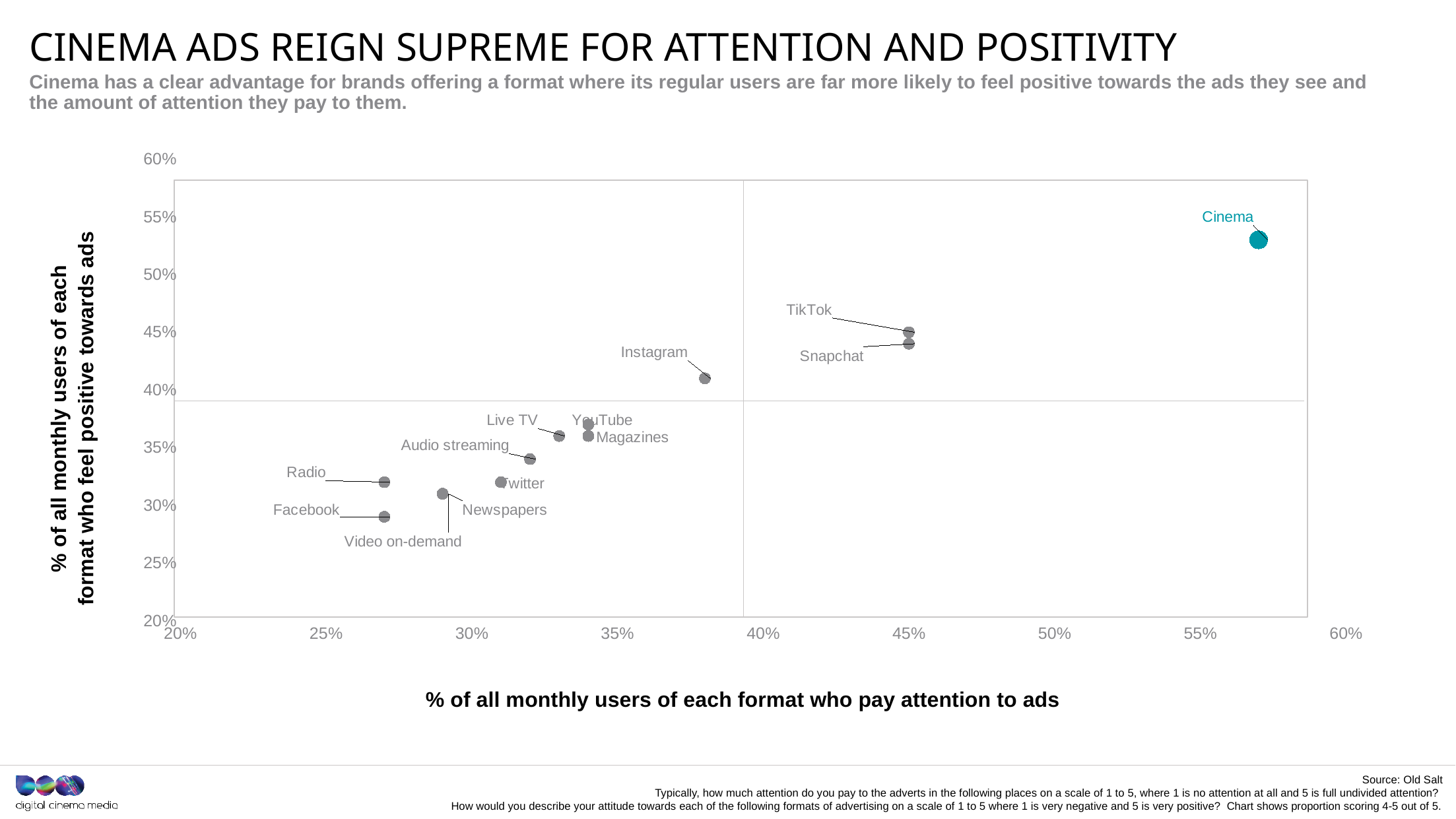
Is the percentage of Cinema users who pay attention to ads greater or less than 55%? greater Which format has the highest percentage of monthly users who pay attention to ads? Cinema Which format has a higher percentage of users who feel positive towards ads, Cinema or Snapchat? Cinema Which format has the lowest percentage of monthly users who feel positive towards ads? Facebook How many advertising formats are labelled on the chart? 13 Is the percentage of Cinema users who feel positive towards ads greater or less than 50%? greater What is the title of the horizontal axis of the chart? % of all monthly users of each format who pay attention to ads Is the percentage of Radio users who pay attention to ads greater or less than 30%? less Which format has the highest percentage of monthly users who feel positive towards ads? Cinema Which format has a higher percentage of users who pay attention to ads, TikTok or Instagram? TikTok What kind of chart is shown on the slide? Scatter chart